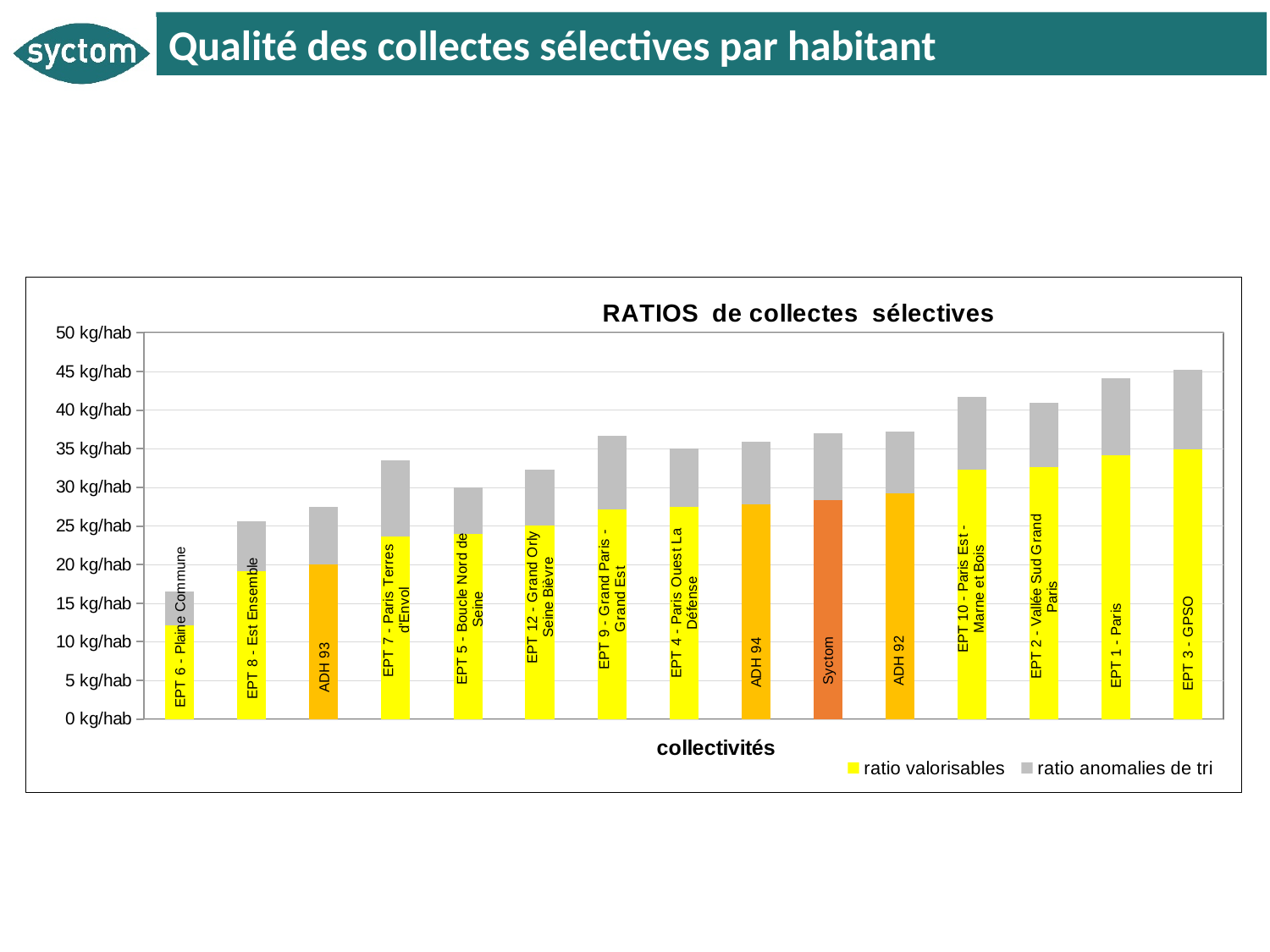
Which collectivité has the highest total bar? EPT 3 - GPSO Do the total bar heights generally rise or fall from left to right along the x axis? rise Which collectivité has the lowest total bar? EPT 6 - Plaine Commune What are the two series named in the legend? ratio valorisables; ratio anomalies de tri Which has a larger total bar, EPT 6 - Plaine Commune or EPT 1 - Paris? EPT 1 - Paris Is the total bar for Syctom greater or less than 35 kg/hab? greater Is the total bar for EPT 6 - Plaine Commune greater or less than 20 kg/hab? less What kind of chart is shown on the slide? stacked bar chart How many collectivités (categories) are plotted in the chart? 15 What is the title of the chart? RATIOS de collectes sélectives Is the total bar for EPT 3 - GPSO greater or less than 40 kg/hab? greater How many series does the legend list? 2